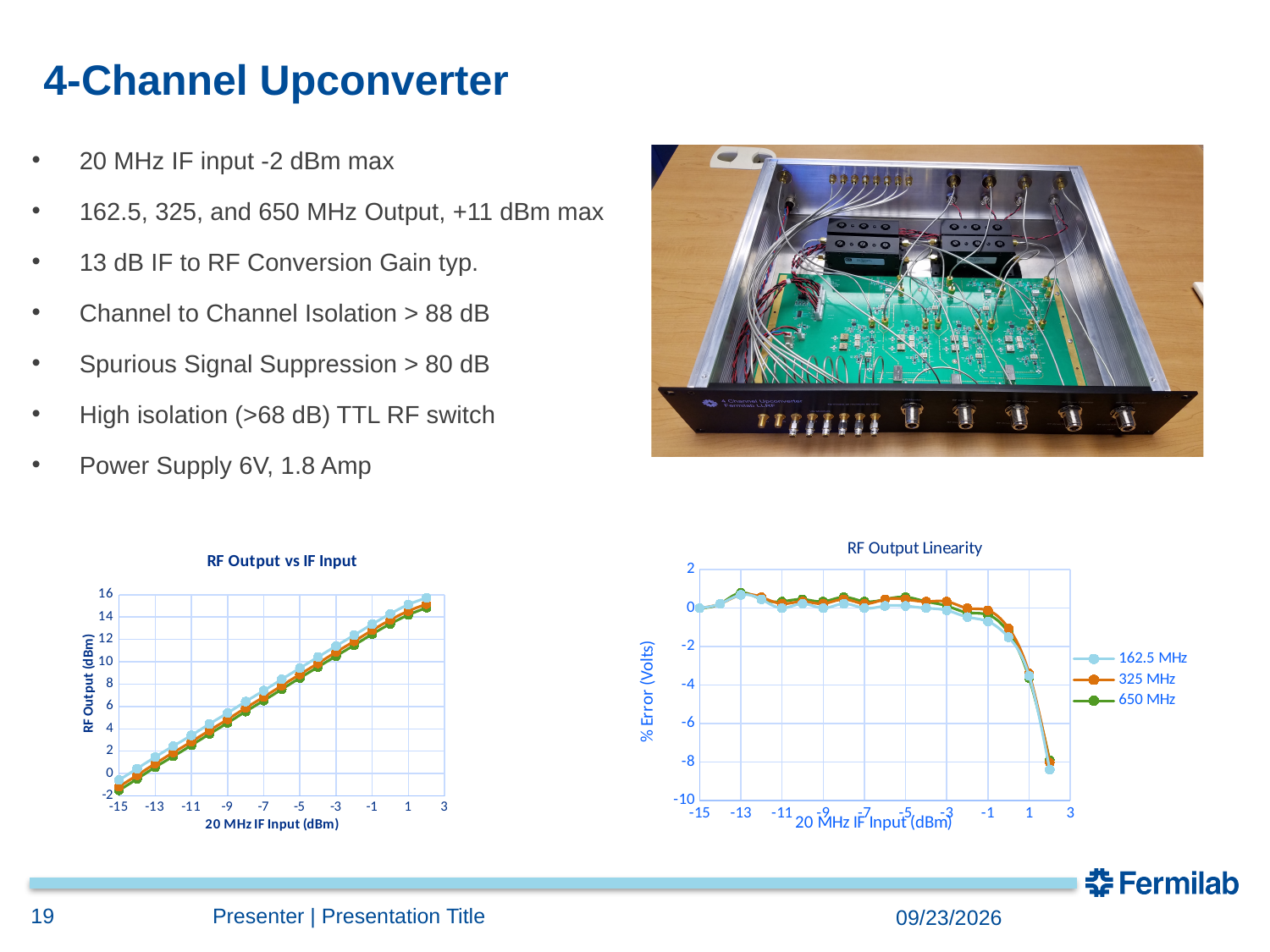
What kind of chart is the 'RF Output vs IF Input' chart? line chart What kind of chart is the 'RF Output Linearity' chart? line chart In the 'RF Output Linearity' chart, is the % error for 162.5 MHz at the highest IF input (about 2 dBm) greater or less than -6? less In the 'RF Output Linearity' chart, which series is drawn in orange? 325 MHz In the 'RF Output vs IF Input' chart, is the RF output at the highest IF input (about 2 dBm) greater or less than 12 dBm? greater In the 'RF Output vs IF Input' chart, do the values rise or fall as the IF input increases? rise In the 'RF Output Linearity' chart, which series are listed in the legend? 162.5 MHz, 325 MHz, 650 MHz In the 'RF Output Linearity' chart, is the % error for 650 MHz at -13 dBm IF input greater or less than -2? greater How many series does the legend of the 'RF Output Linearity' chart list? 3 What is the y-axis label of the 'RF Output vs IF Input' chart? RF Output (dBm) In the 'RF Output Linearity' chart, do the values rise or fall as the IF input goes from -1 dBm to 3 dBm? fall